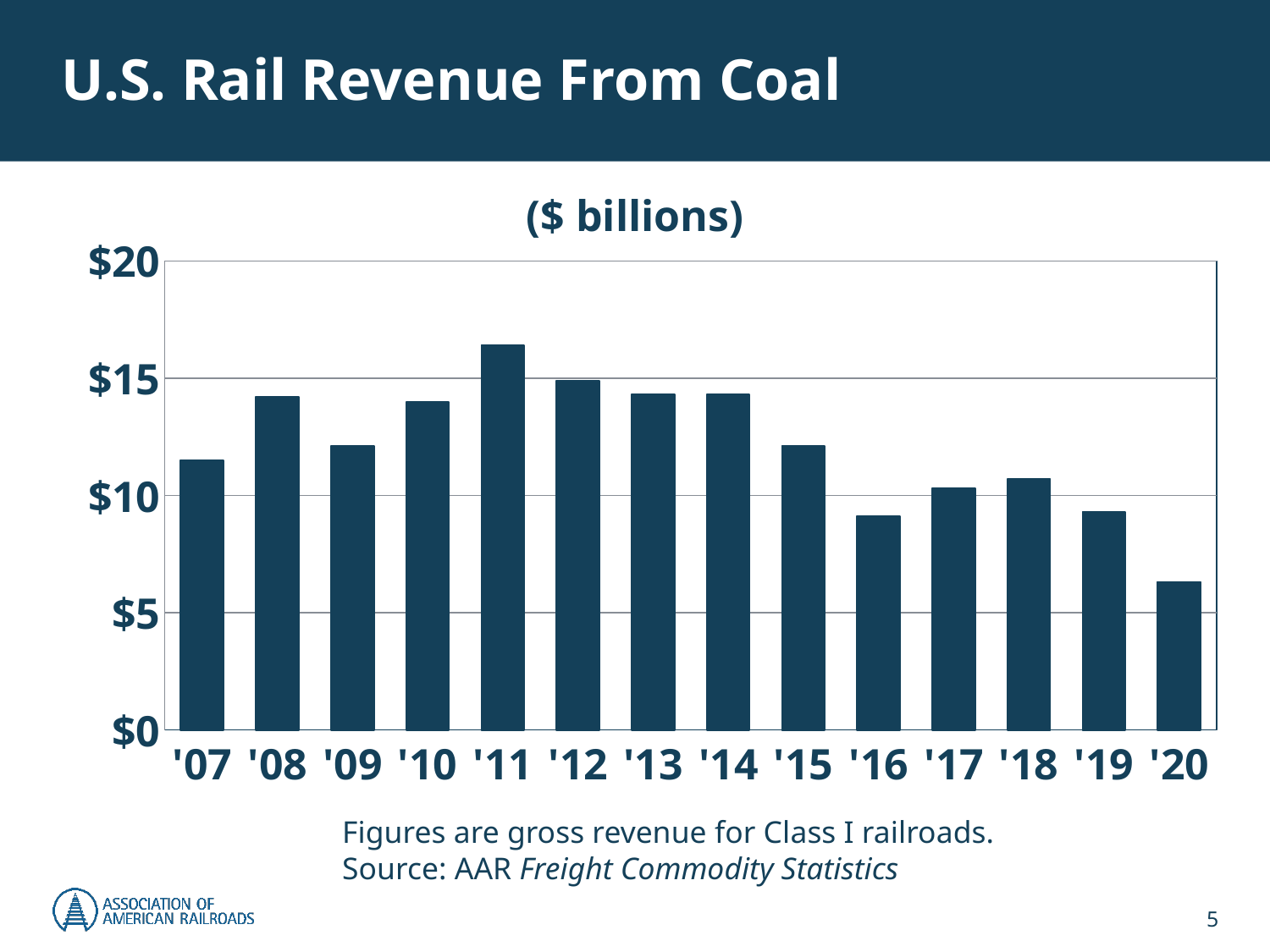
Is the value for '07 greater or less than $10? greater What kind of chart is shown on the slide? bar chart Which year has the lowest rail revenue from coal? '20 Which year has the larger value, '16 or '17? '17 How many years are plotted in the chart? 14 Is the value for '11 greater or less than $15? greater Which year has the larger value, '08 or '09? '08 In what units are the values on the chart expressed? $ billions Is the value for '20 greater or less than $5? greater Which year has the highest rail revenue from coal? '11 Do the values generally rise or fall from '14 to '20? fall